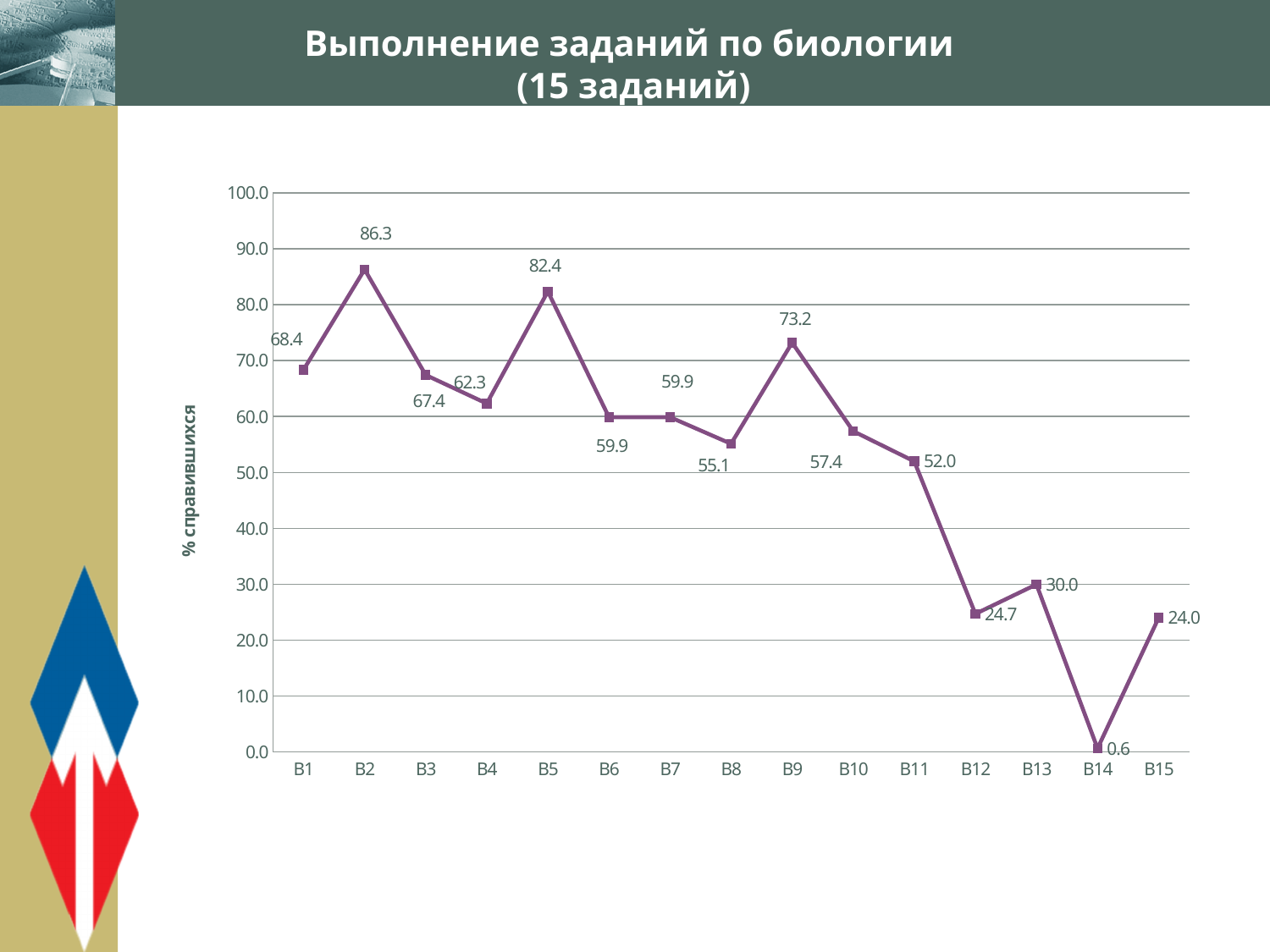
What kind of chart is shown on the slide? line chart Which task has the highest percentage of students who completed it? B2 Is the value for B11 greater or less than 60.0? less What is the label of the vertical axis? % справившихся Which is larger, the value for B1 or the value for B3? B1 How many tasks are plotted on the x axis? 15 What is the value for B2? 86.3 What is the value for B9? 73.2 What is the value for B14? 0.6 What is the difference between the values for B2 and B5? 3.9 Which task has the lowest percentage of students who completed it? B14 What is the difference between the values for B13 and B12? 5.3